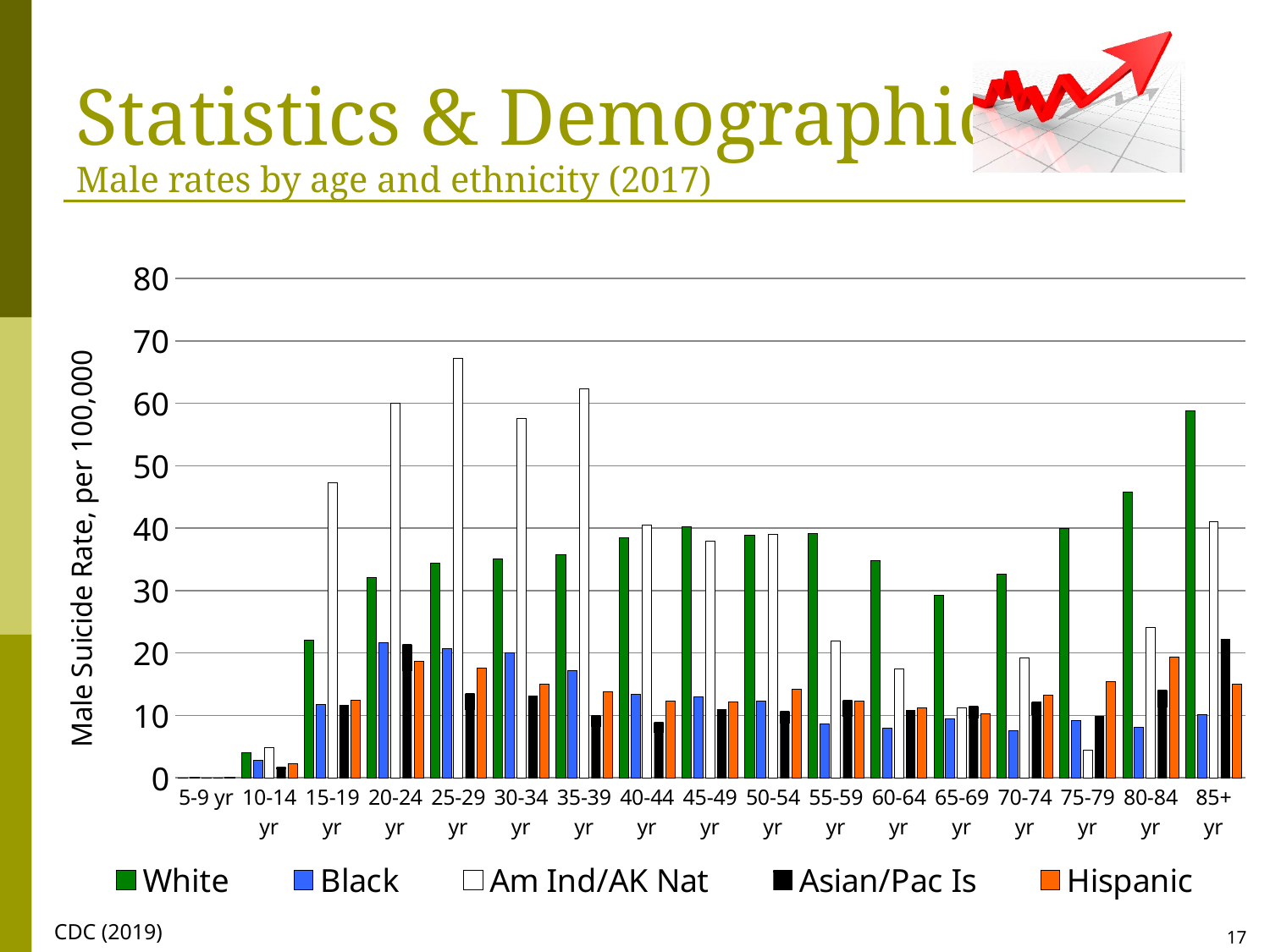
Which age group has the highest Am Ind/AK Nat male suicide rate? 25-29 yr Which age group has the lowest White male suicide rate? 5-9 yr How many series does the legend list? 5 Is the White male suicide rate for the 85+ yr group greater or less than 50? greater What kind of chart is shown on the slide? bar chart Is the Black male suicide rate for the 15-19 yr group greater or less than 20? less Which age group has the highest White male suicide rate? 85+ yr In the 75-79 yr group, which is larger: the White rate or the Am Ind/AK Nat rate? White How many age groups are shown on the x axis? 17 Is the Am Ind/AK Nat male suicide rate for the 20-24 yr group greater or less than 50? greater What is the label on the y axis of the chart? Male Suicide Rate, per 100,000 In the 25-29 yr group, which is larger: the White rate or the Am Ind/AK Nat rate? Am Ind/AK Nat